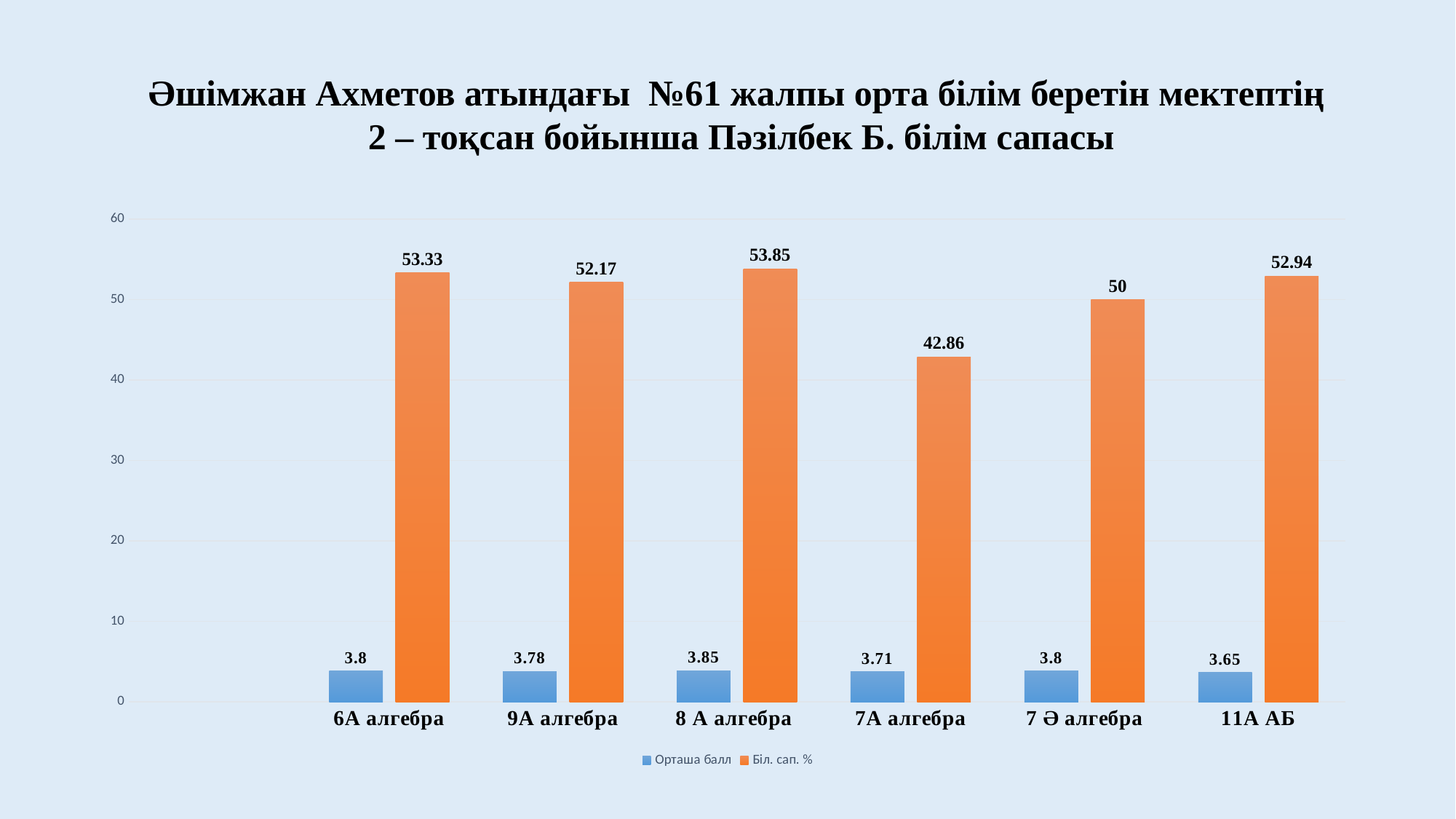
Which category has the highest Біл. сап. % value? 8 А алгебра Is the Біл. сап. % value for 7А алгебра greater or less than 50? less Which category has the lowest Біл. сап. % value? 7А алгебра What is the Орташа балл value for 7А алгебра? 3.71 Which category has the lowest Орташа балл value? 11А АБ What kind of chart is shown on the slide? bar chart How many categories are shown on the x axis? 6 How many series does the legend list? 2 What is the Біл. сап. % value for 8 А алгебра? 53.85 What is the Біл. сап. % value for 7 Ә алгебра? 50 What is the difference between the Біл. сап. % values for 6А алгебра and 7А алгебра? 10.47 Which is larger, the Біл. сап. % value for 9А алгебра or for 11А АБ? 11А АБ